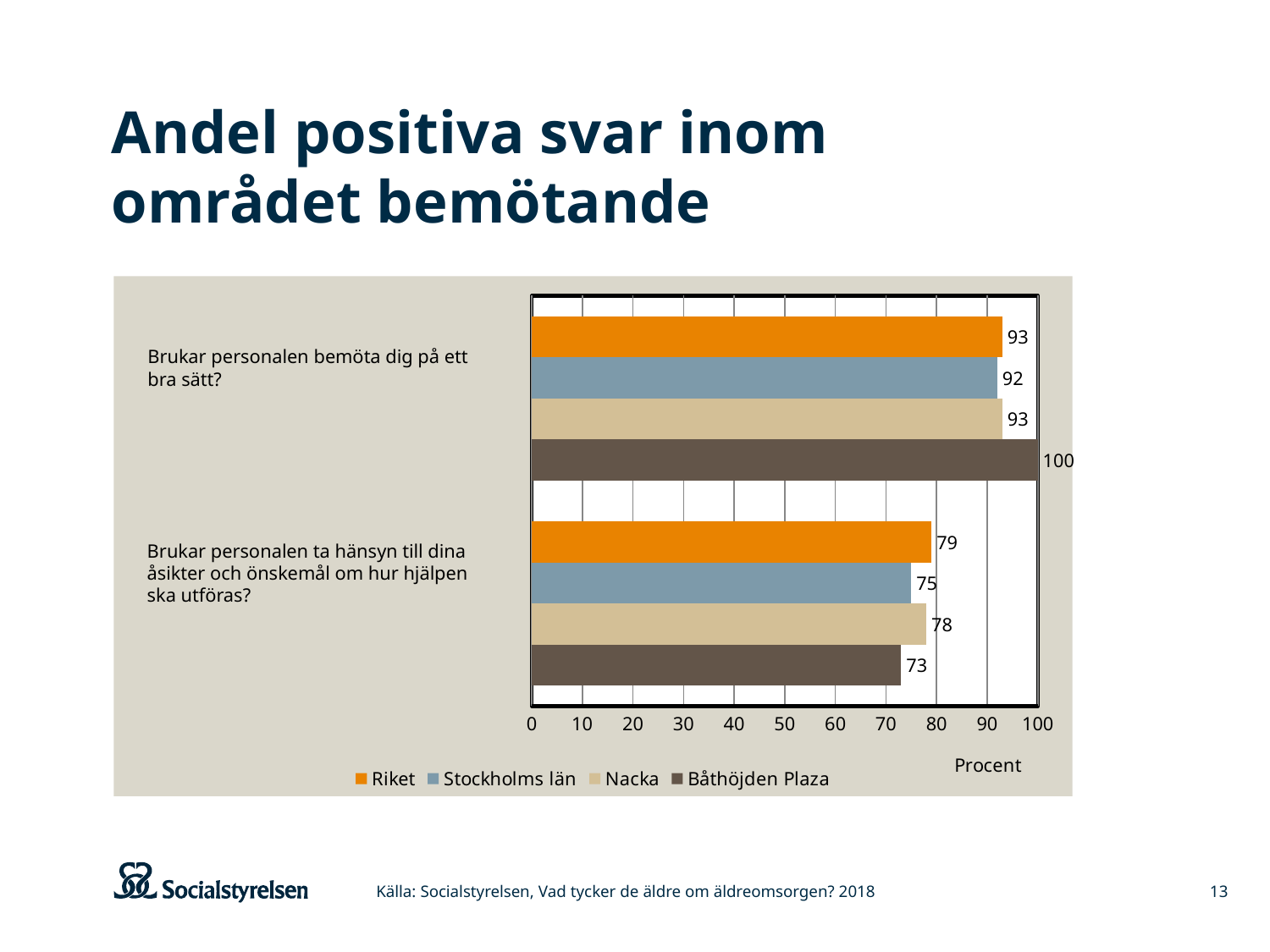
How many series does the legend list? 4 Which series has the highest value for the question "Brukar personalen bemöta dig på ett bra sätt?"? Båthöjden Plaza Which is larger for the question "Brukar personalen ta hänsyn till dina åsikter och önskemål om hur hjälpen ska utföras?": Riket or Nacka? Riket What is the value for Riket for the question "Brukar personalen bemöta dig på ett bra sätt?"? 93 Which series has the lowest value for the question "Brukar personalen ta hänsyn till dina åsikter och önskemål om hur hjälpen ska utföras?"? Båthöjden Plaza What is the difference between Riket and Stockholms län for the question "Brukar personalen ta hänsyn till dina åsikter och önskemål om hur hjälpen ska utföras?"? 4 What is the value for Stockholms län for the question "Brukar personalen ta hänsyn till dina åsikter och önskemål om hur hjälpen ska utföras?"? 75 What is the label on the horizontal axis of the chart? Procent What is the value for Nacka for the question "Brukar personalen ta hänsyn till dina åsikter och önskemål om hur hjälpen ska utföras?"? 78 What is the value for Båthöjden Plaza for the question "Brukar personalen bemöta dig på ett bra sätt?"? 100 What is the difference between the Båthöjden Plaza values for the two questions? 27 What kind of chart is shown on the slide? Bar chart